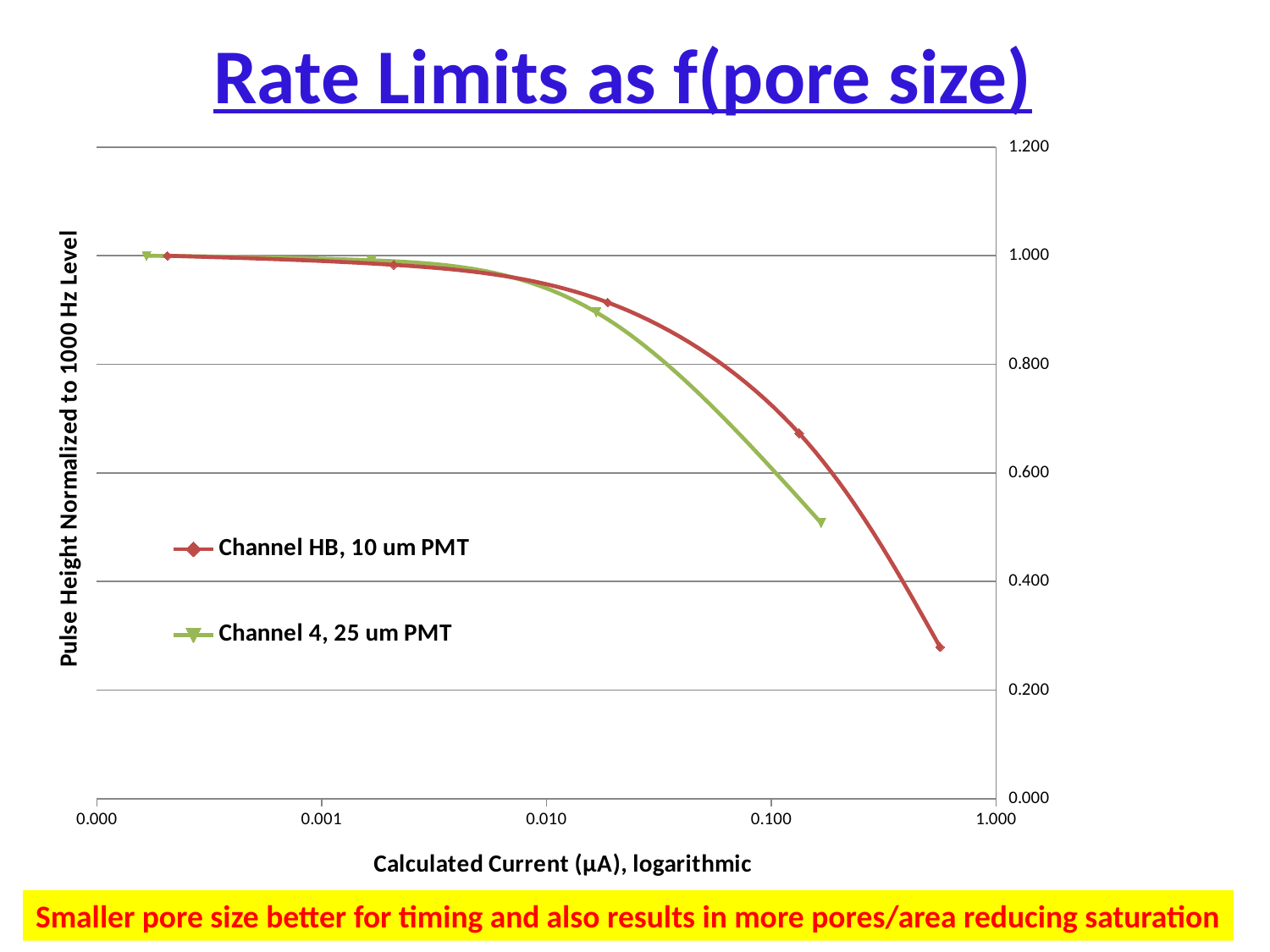
Is the lowest plotted value for Channel HB, 10 um PMT greater or less than 0.400? less How many series does the legend list? 2 Do the values for Channel HB, 10 um PMT rise or fall as the calculated current increases? fall What is the label of the x axis? Calculated Current (µA), logarithmic What is the title of the chart? Rate Limits as f(pore size) Is the lowest plotted value for Channel 4, 25 um PMT greater or less than 0.400? greater What kind of chart is shown on the slide? line chart How many data points are plotted for Channel 4, 25 um PMT? 4 Which series reaches the lower pulse height at its last plotted point, Channel HB, 10 um PMT or Channel 4, 25 um PMT? Channel HB, 10 um PMT How many data points are plotted for Channel HB, 10 um PMT? 5 Is the lowest plotted value for Channel 4, 25 um PMT greater or less than 0.600? less Do the values for Channel 4, 25 um PMT rise or fall along the x axis? fall